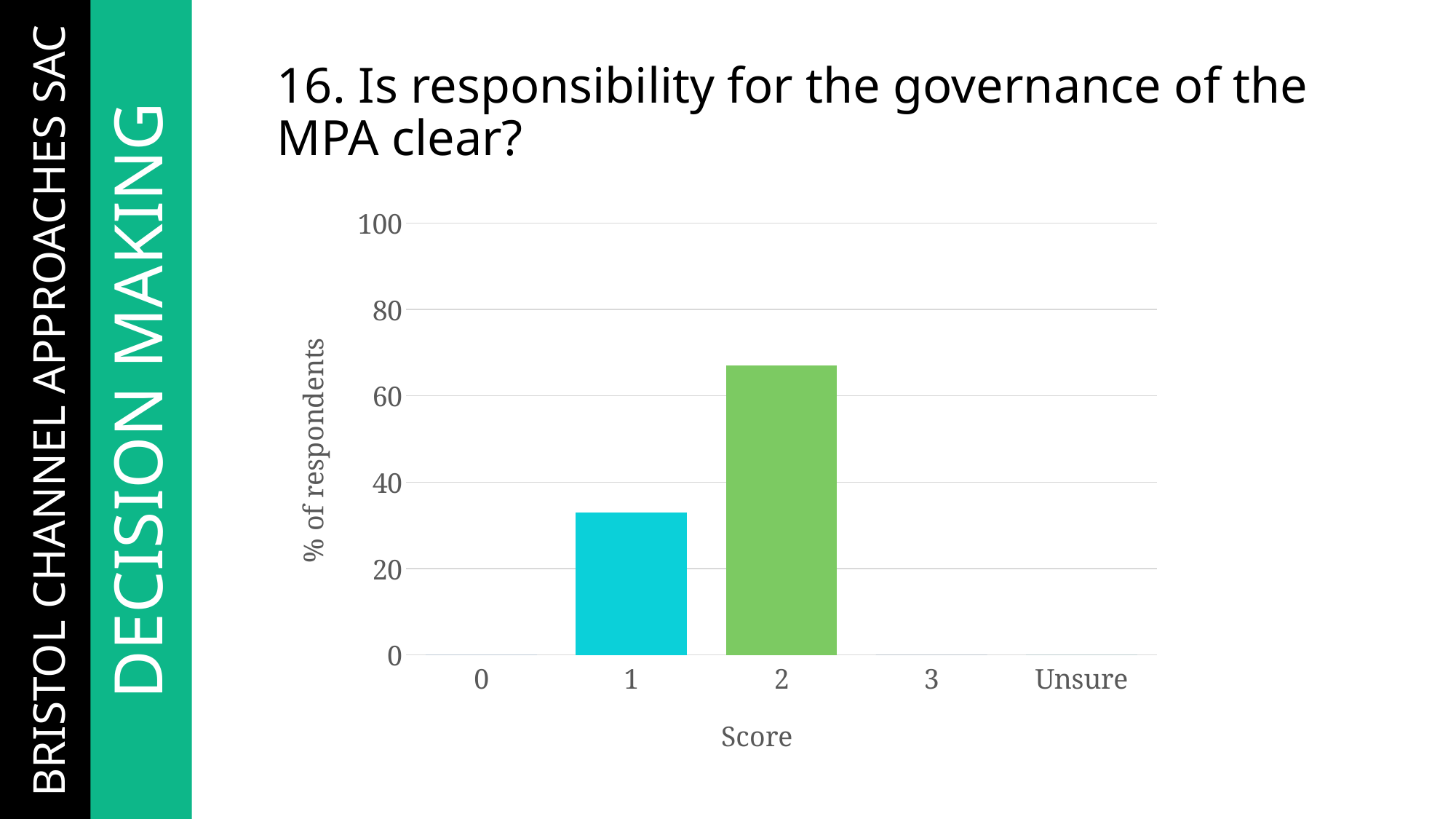
What kind of chart is shown on the slide? bar chart Which is larger, the value for score 1 or the value for score 2? score 2 How many categories are shown on the x axis of the chart? 5 Is the value for score 2 greater or less than 80? less How many of the categories on the x axis have a visible bar? 2 Which score has the highest percentage of respondents? 2 What is the label of the y axis? % of respondents Is the value for score 1 greater or less than 20? greater Is the value for score 1 greater or less than 40? less What is the label of the x axis? Score